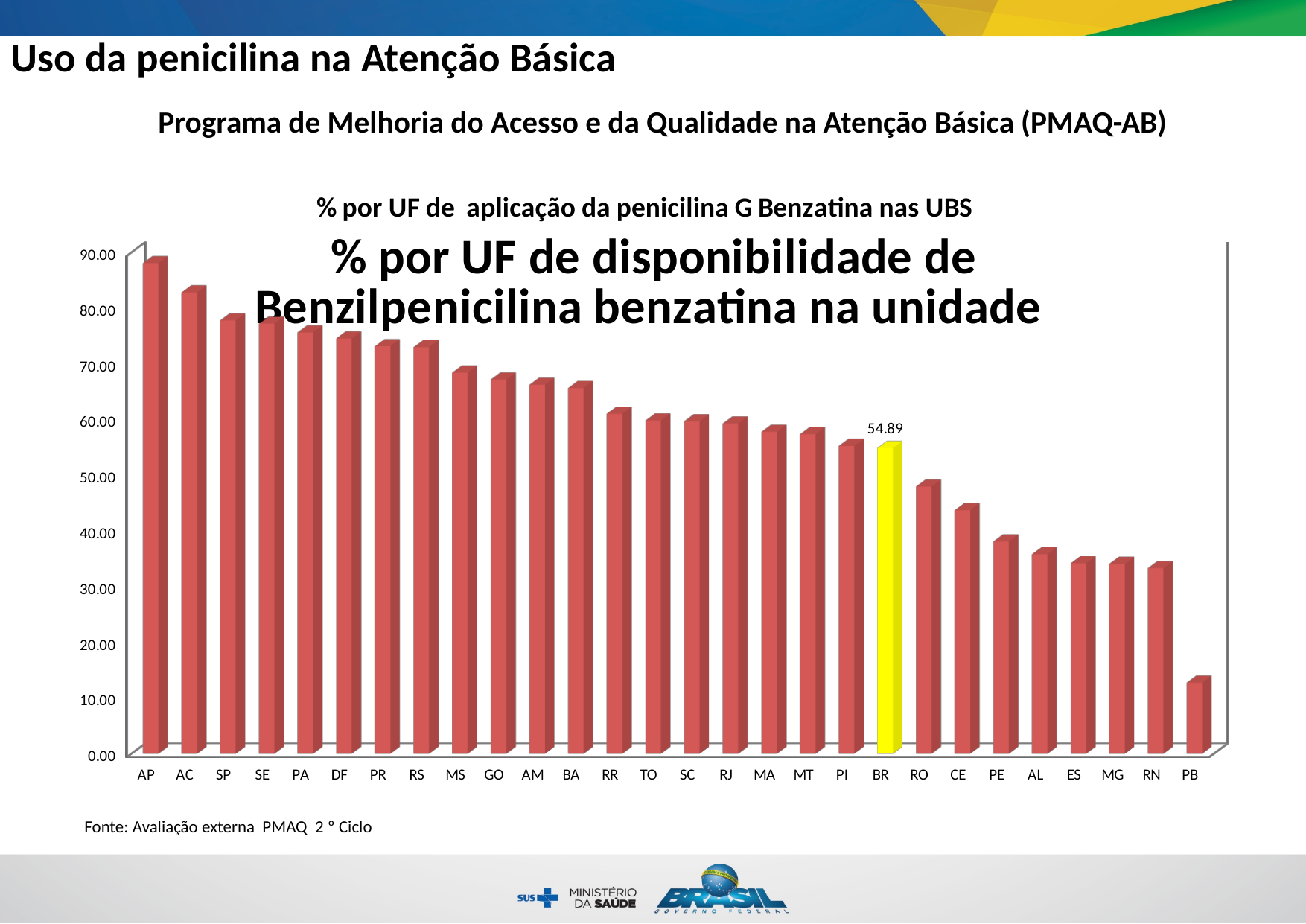
Do the bar values rise or fall from left to right along the x axis? Fall Which UF has the highest bar in the chart? AP Which bar in the chart is highlighted in yellow? BR Which has the larger value, SP or RO? SP Is the value for AP greater or less than 80.00? greater Is the value for AL greater or less than 40.00? less Which has the larger value, BR or CE? BR Which UF has the lowest bar in the chart? PB What kind of chart is shown on the slide? Bar chart Is the value for PB greater or less than 20.00? less How many categories are shown on the x axis of the chart? 28 What value is shown for BR in the chart? 54.89